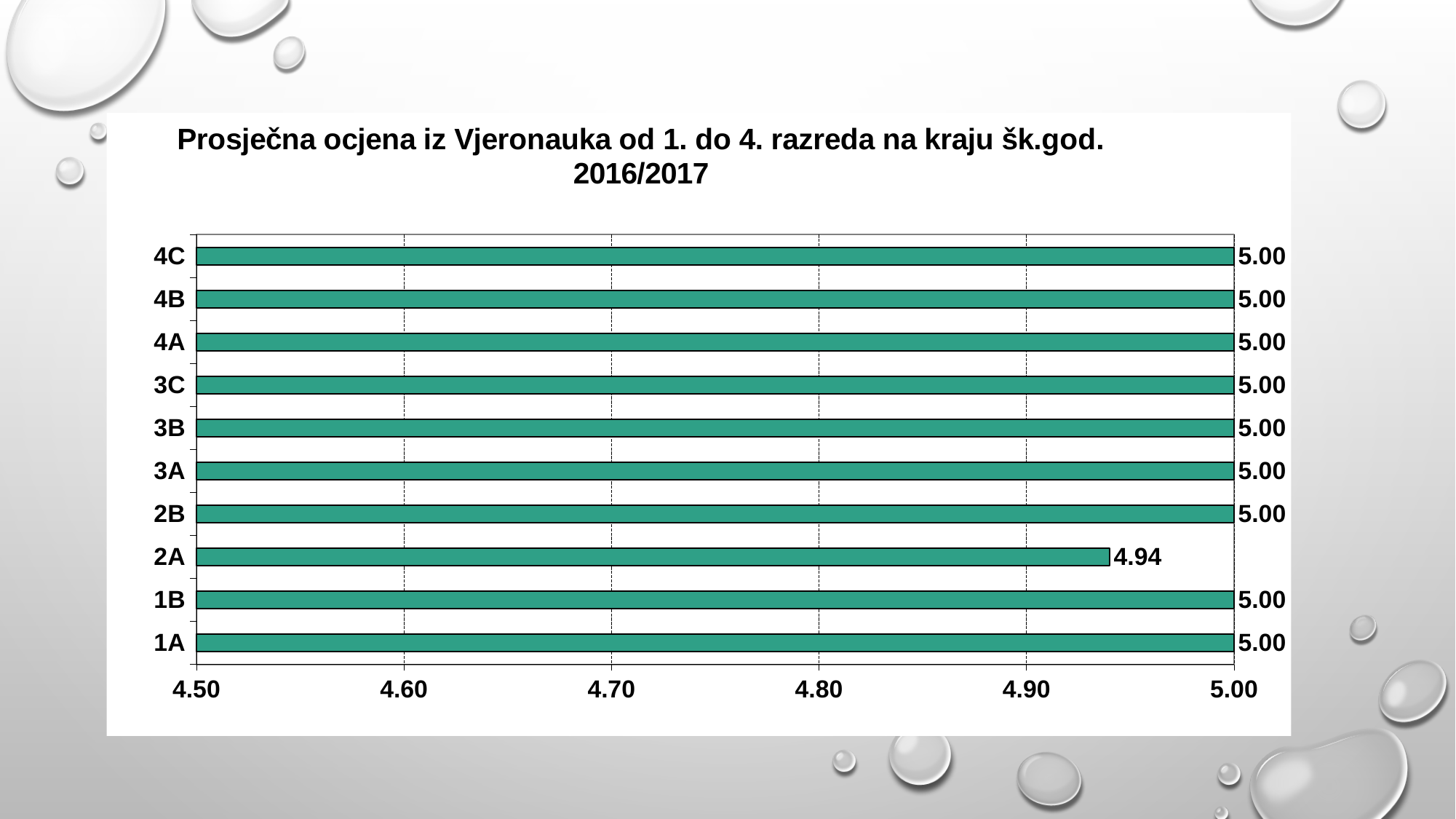
What is the value for 2A? 4.94 What is the difference between the values for 2B and 2A? 0.06 Which category has the lowest value? 2A Which is larger, the value for 3A or the value for 2A? 3A What is the value for 4C? 5.00 What is the title of the chart? Prosječna ocjena iz Vjeronauka od 1. do 4. razreda na kraju šk.god. 2016/2017 What is the value for 1B? 5.00 What kind of chart is this? bar chart How many categories have a value of 5.00? 9 Is the value for 2A greater or less than 4.90? greater What is the highest value shown on the x axis? 5.00 How many categories are shown on the chart? 10